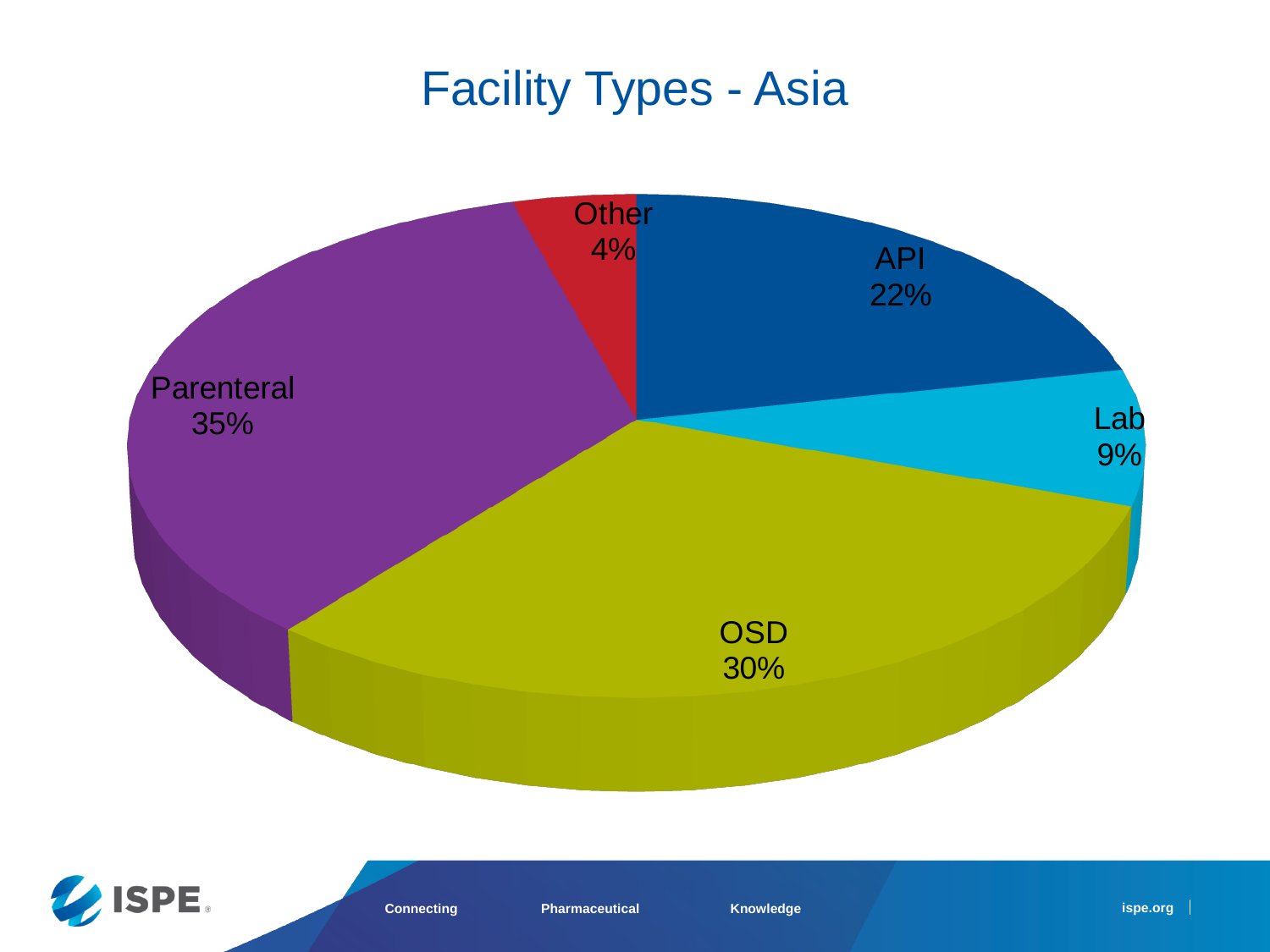
What is the difference in percentage points between Parenteral and OSD? 5 What is the title of the chart? Facility Types - Asia What kind of chart is shown on the slide? Pie chart Which is larger, the share for API or the share for Lab? API What is the value shown for Lab? 9% What colour is the OSD slice? Yellow-green Which facility type has the largest share of the pie? Parenteral What is the value shown for OSD? 30% What share of the pie does Parenteral represent? 35% How many slices does the pie chart have? 5 Which facility type has the smallest share of the pie? Other What is the value shown for API? 22%